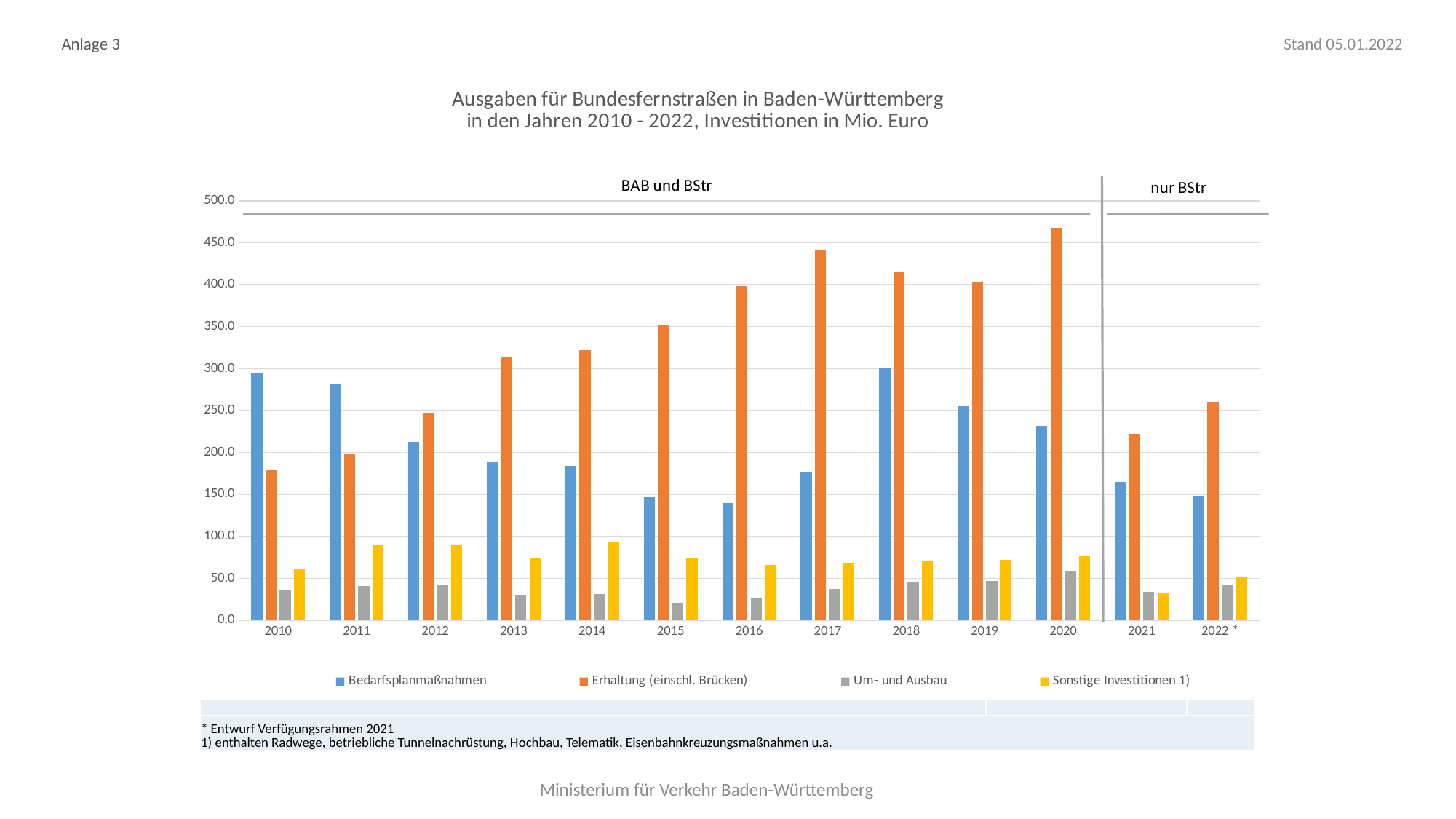
Is the value for Um- und Ausbau in 2020 greater or less than 50? greater Does the value for Erhaltung (einschl. Brücken) rise or fall from 2010 to 2017? rise In which year is the value for Sonstige Investitionen 1) lowest? 2021 Is the value for Erhaltung (einschl. Brücken) in 2017 greater or less than 400? greater What kind of chart is shown on the slide? bar chart In 2010, which is larger: Bedarfsplanmaßnahmen or Erhaltung (einschl. Brücken)? Bedarfsplanmaßnahmen How many years are shown on the x axis? 13 Is the value for Bedarfsplanmaßnahmen in 2016 greater or less than 150? less How many series does the legend list? 4 In which year is the value for Um- und Ausbau lowest? 2015 Which series is shown in orange in the legend? Erhaltung (einschl. Brücken) In which year is the value for Erhaltung (einschl. Brücken) highest? 2020